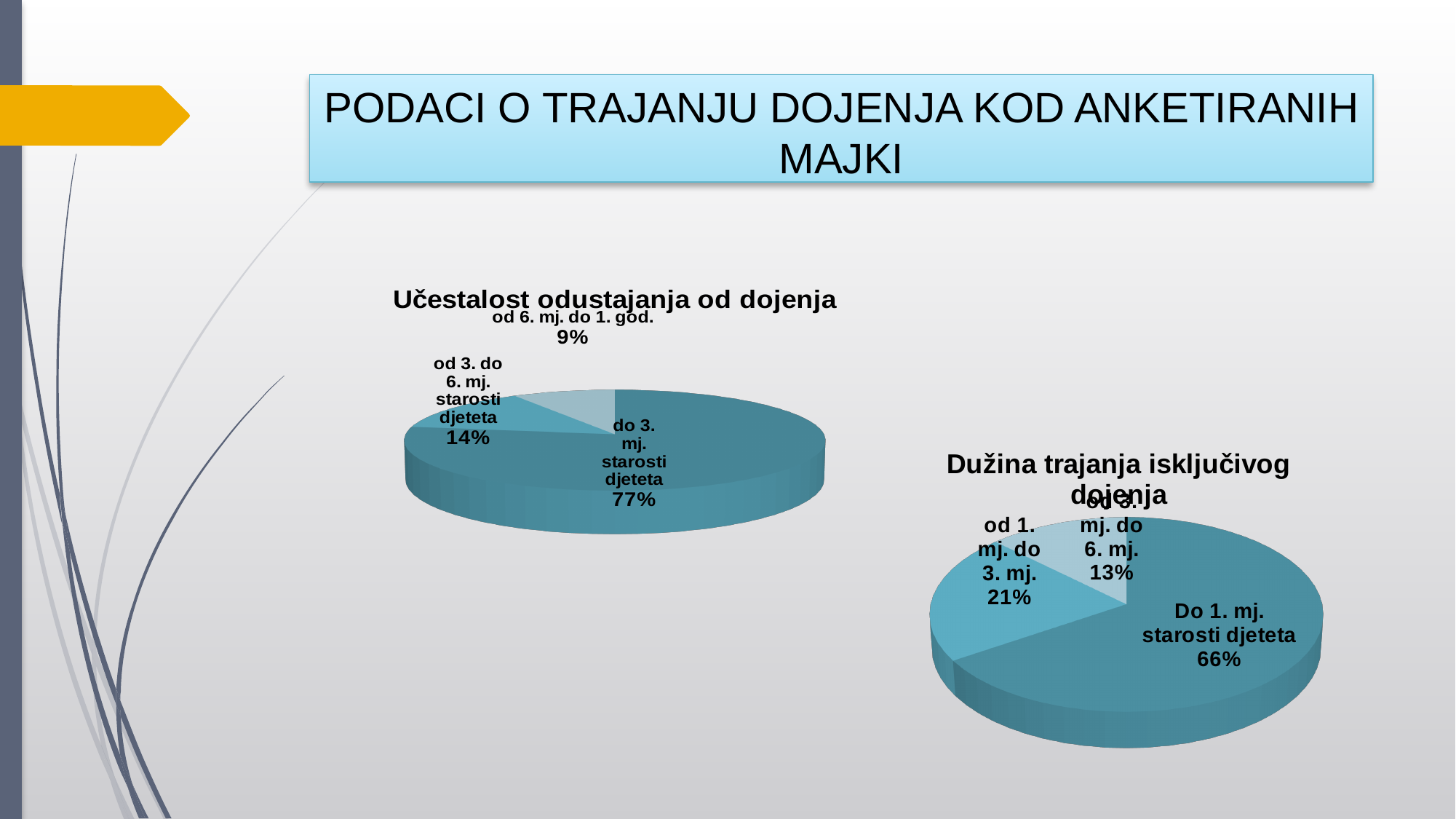
In the chart titled "Dužina trajanja isključivog dojenja", what share is shown for "od 1. mj. do 3. mj."? 21% In the chart titled "Učestalost odustajanja od dojenja", which category has the largest slice? do 3. mj. starosti djeteta In the chart titled "Učestalost odustajanja od dojenja", what share is shown for "do 3. mj. starosti djeteta"? 77% In the chart titled "Učestalost odustajanja od dojenja", how many slices does the pie have? 3 In the chart titled "Dužina trajanja isključivog dojenja", which category has the smallest slice? od 3. mj. do 6. mj. In the chart titled "Učestalost odustajanja od dojenja", what share is shown for "od 6. mj. do 1. god."? 9% What type of chart is the chart on the right of the slide? Pie chart In the chart titled "Učestalost odustajanja od dojenja", what share is shown for "od 3. do 6. mj. starosti djeteta"? 14% In the chart titled "Dužina trajanja isključivog dojenja", what share is shown for "od 3. mj. do 6. mj."? 13% In the chart titled "Dužina trajanja isključivog dojenja", what is the difference in percentage points between "Do 1. mj. starosti djeteta" and "od 1. mj. do 3. mj."? 45 percentage points In the chart titled "Učestalost odustajanja od dojenja", which category has the smallest slice? od 6. mj. do 1. god. In the chart titled "Dužina trajanja isključivog dojenja", what share is shown for "Do 1. mj. starosti djeteta"? 66%